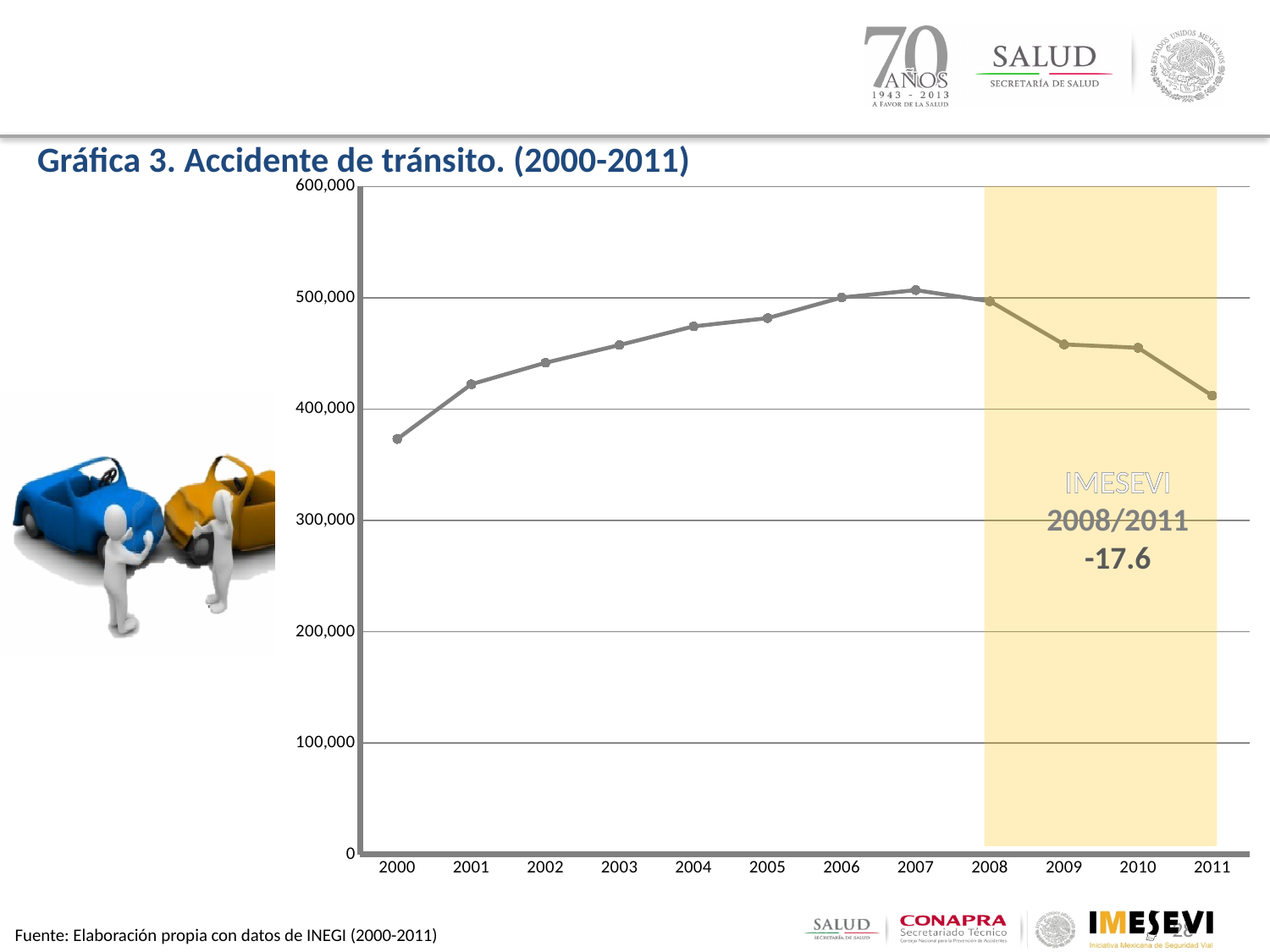
Is the value for 2009 greater or less than 500,000? less Which year has the highest value in the chart? 2007 Which year has the larger value, 2000 or 2011? 2011 Is the value for 2004 greater or less than 400,000? greater Do the values rise or fall from 2000 to 2007? rise Which year has the lowest value in the chart? 2000 Is the value for 2011 greater or less than 400,000? greater What kind of chart is shown on the slide? line chart How many years are plotted on the x axis of the chart? 12 Do the values rise or fall from 2008 to 2011? fall What is the title of the chart? Gráfica 3. Accidente de tránsito. (2000-2011)